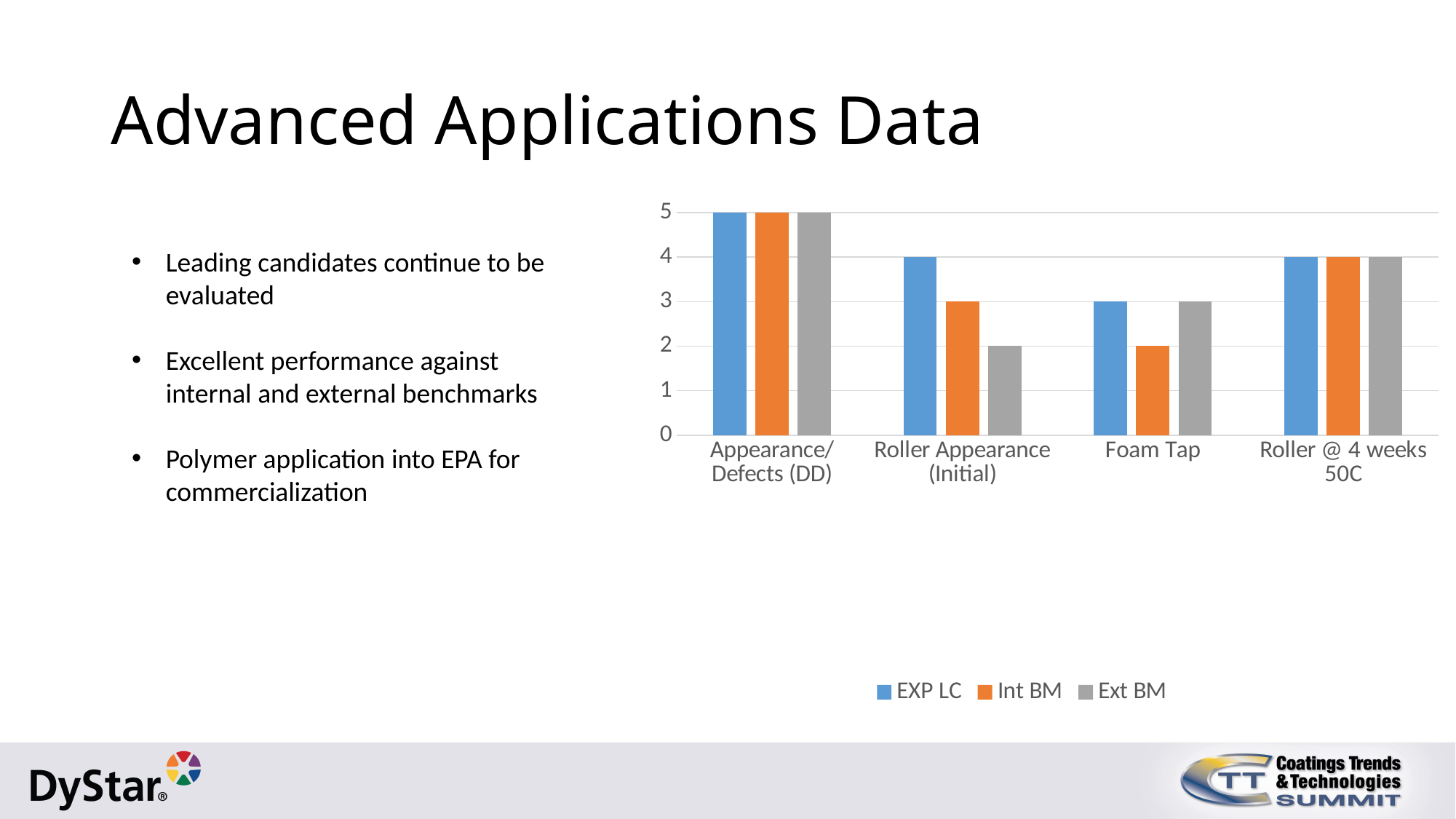
What is the difference between the EXP LC and Ext BM values in the Roller Appearance (Initial) category? 2 What type of chart is shown on the slide? bar chart Which series is shown in orange in the legend? Int BM How many categories are shown on the x axis? 4 How many series does the legend list? 3 Which series has the lowest value in the Foam Tap category? Int BM Which series has the lowest value in the Roller Appearance (Initial) category? Ext BM What is the value for Ext BM in the Roller Appearance (Initial) category? 2 Which is larger in the Foam Tap category, the EXP LC value or the Int BM value? EXP LC What is the value for EXP LC in the Appearance/Defects (DD) category? 5 What is the value for Int BM in the Foam Tap category? 2 What is the value for EXP LC in the Roller Appearance (Initial) category? 4